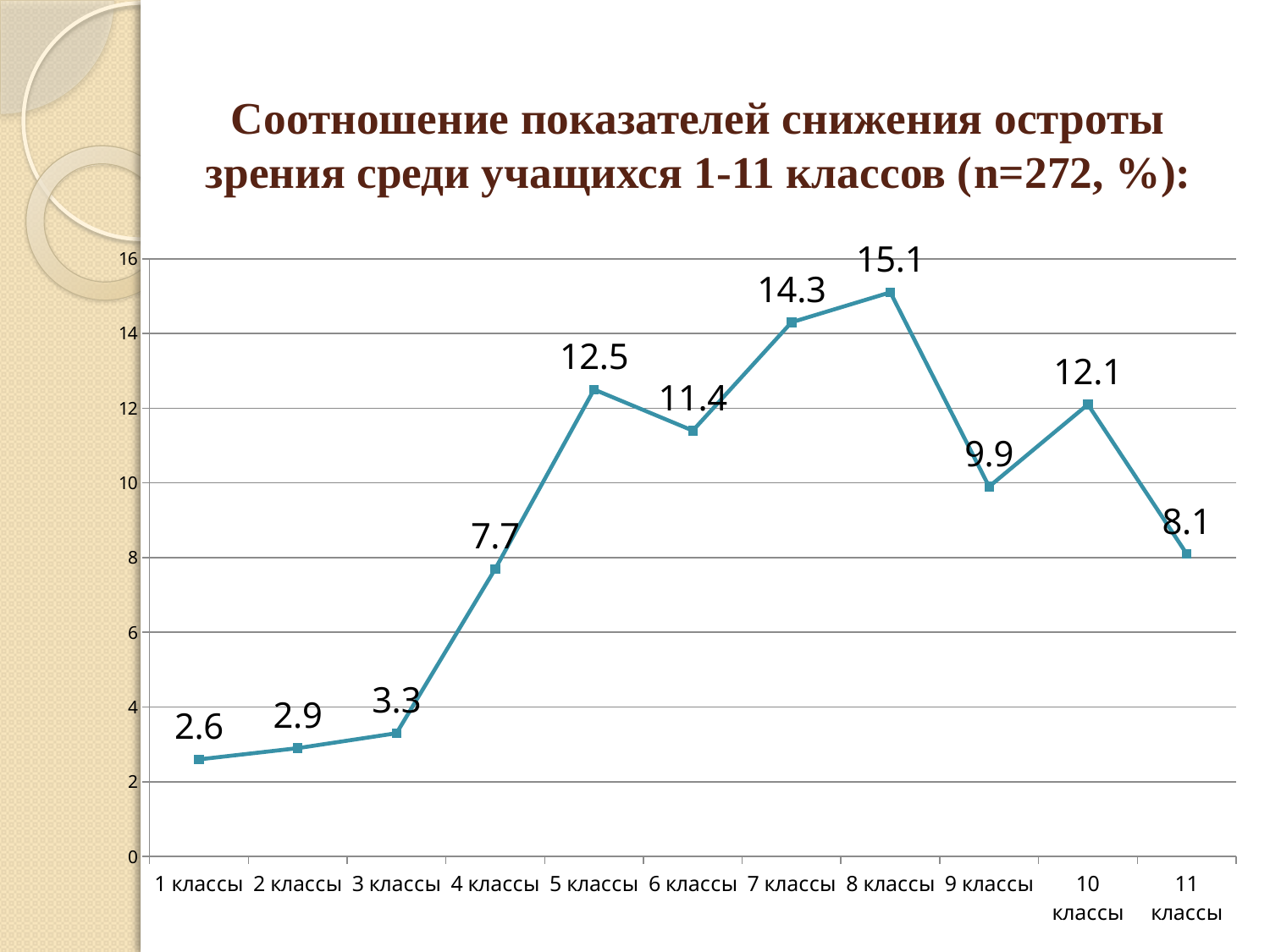
How many categories are shown on the x axis? 11 What is the value for 1 классы? 2.6 What kind of chart is shown on the slide? line chart What is the value for 5 классы? 12.5 Which is larger, the value for 6 классы or the value for 7 классы? 7 классы Is the value for 4 классы greater or less than 8? less Which category has the lowest value? 1 классы What is the difference between the values for 3 классы and 4 классы? 4.4 Which category has the highest value? 8 классы What is the value for 10 классы? 12.1 What is the difference between the values for 8 классы and 9 классы? 5.2 Do the values rise or fall from 1 классы to 4 классы? rise